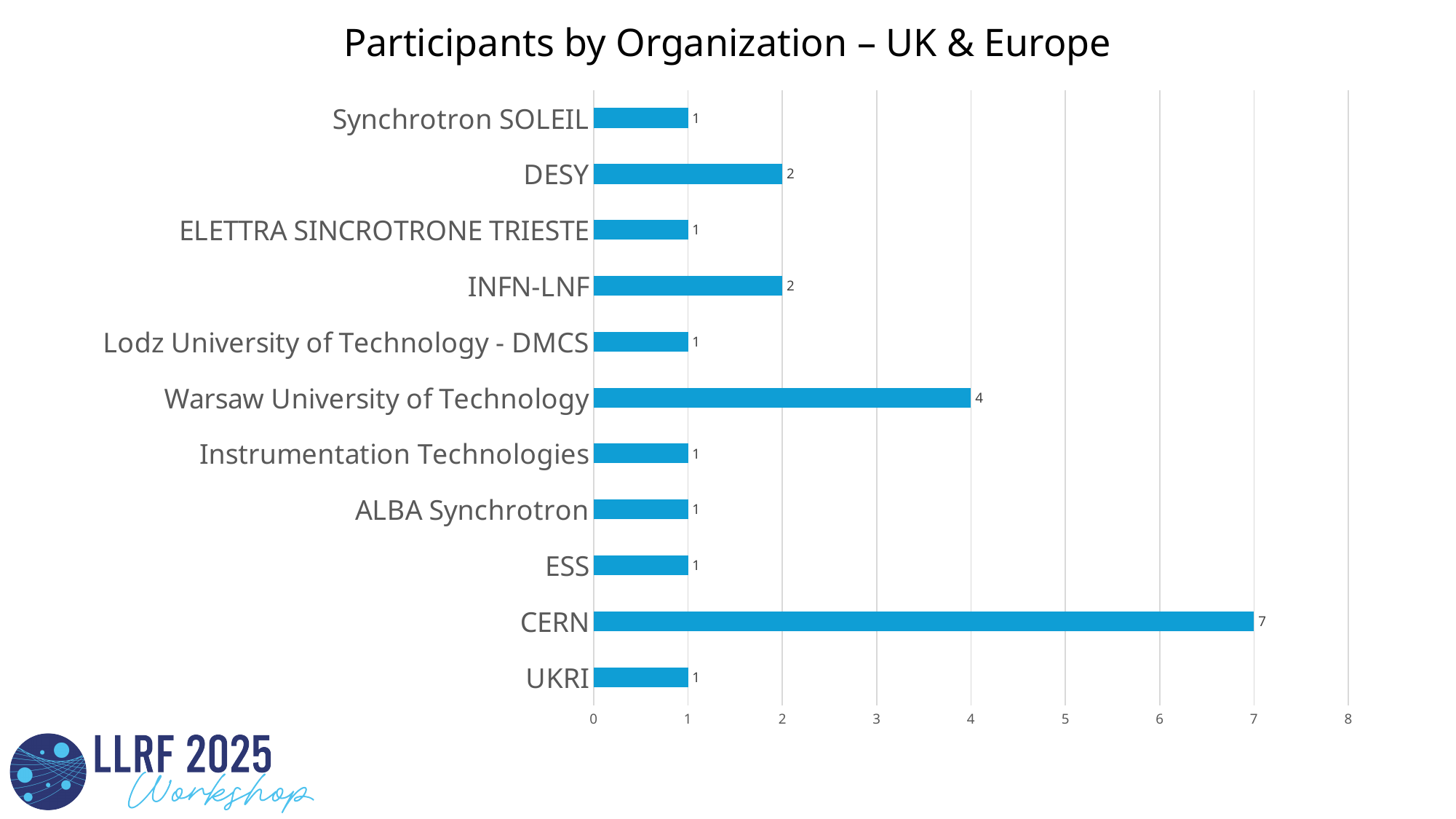
Which organization has the highest number of participants? CERN How many organizations have exactly 1 participant? 7 What kind of chart is shown on the slide? Bar chart How many participants does CERN have? 7 How many participants does DESY have? 2 What is the difference in participants between CERN and Warsaw University of Technology? 3 Which has more participants, DESY or ESS? DESY What is the total number of participants across all organizations shown? 22 How many participants does Warsaw University of Technology have? 4 How many organizations are shown in the chart? 11 How many participants does INFN-LNF have? 2 What is the title of the chart? Participants by Organization – UK & Europe